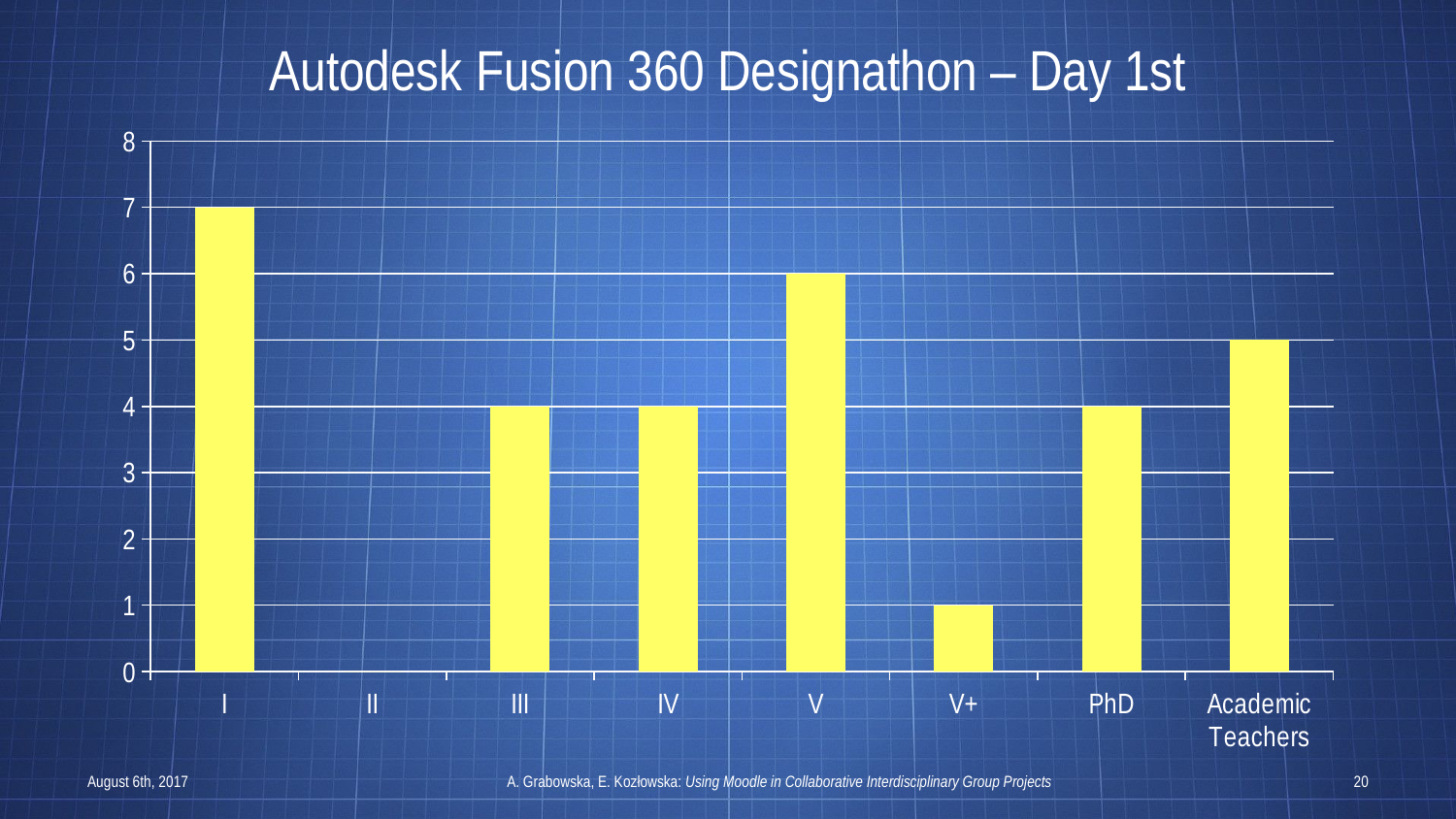
Which category has the highest bar? I Which category has the shortest bar among the bars shown? V+ What is the value for PhD? 4 What is the difference between the values for I and V? 1 What is the value for category I? 7 Which is larger, the value for Academic Teachers or the value for PhD? Academic Teachers What is the title of the chart? Autodesk Fusion 360 Designathon – Day 1st What is the value for Academic Teachers? 5 What is the value for V+? 1 What type of chart is shown on the slide? bar chart What is the value for category V? 6 How many categories are shown on the x axis? 8